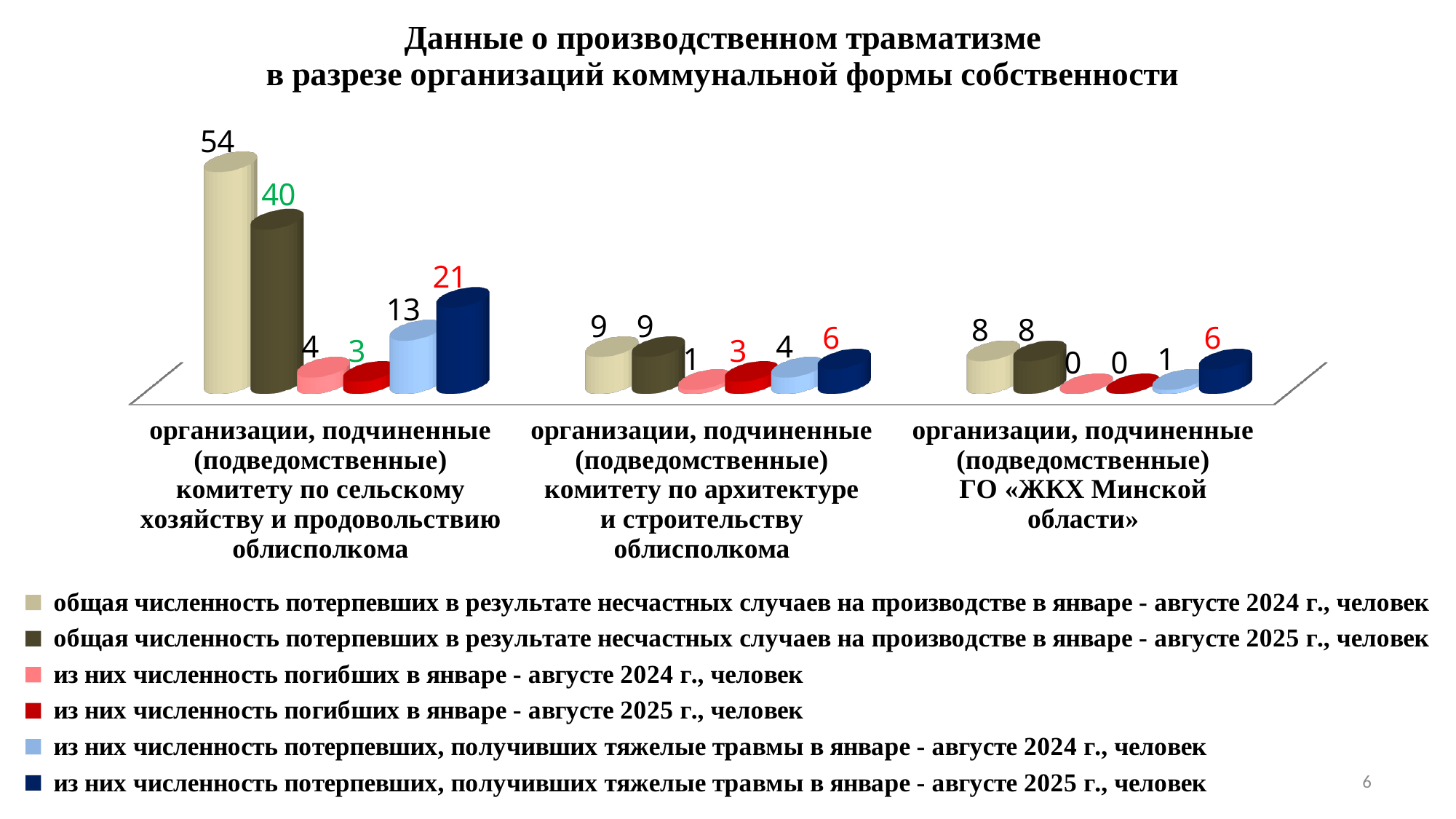
Which category has the lowest total number of injured persons in January–August 2025? организации, подчиненные (подведомственные) ГО «ЖКХ Минской области» What is the total number of injured persons in January–August 2025 for organizations subordinate to the committee for agriculture and food (комитет по сельскому хозяйству и продовольствию облисполкома)? 40 How many fatalities were there in January–August 2025 in organizations subordinate to the committee for architecture and construction (комитет по архитектуре и строительству облисполкома)? 3 How many persons received severe injuries in January–August 2025 in organizations subordinate to the committee for agriculture and food (комитет по сельскому хозяйству и продовольствию облисполкома)? 21 How many categories (groups of organizations) are shown on the chart? 3 What is the total number of injured persons in January–August 2024 for organizations subordinate to the committee for agriculture and food of the regional executive committee (комитет по сельскому хозяйству и продовольствию облисполкома)? 54 How many series does the legend list? 6 Which is larger for organizations subordinate to the committee for architecture and construction (комитет по архитектуре и строительству облисполкома): the number of severely injured in January–August 2024 or in January–August 2025? January–August 2025 By how much did the total number of injured persons in organizations subordinate to the committee for agriculture and food (комитет по сельскому хозяйству и продовольствию облисполкома) decrease from January–August 2024 to January–August 2025? 14 Which category has the highest total number of injured persons in January–August 2024? организации, подчиненные (подведомственные) комитету по сельскому хозяйству и продовольствию облисполкома How many fatalities were there in January–August 2024 in organizations subordinate to ГО «ЖКХ Минской области»? 0 What type of chart is shown on the slide? bar chart